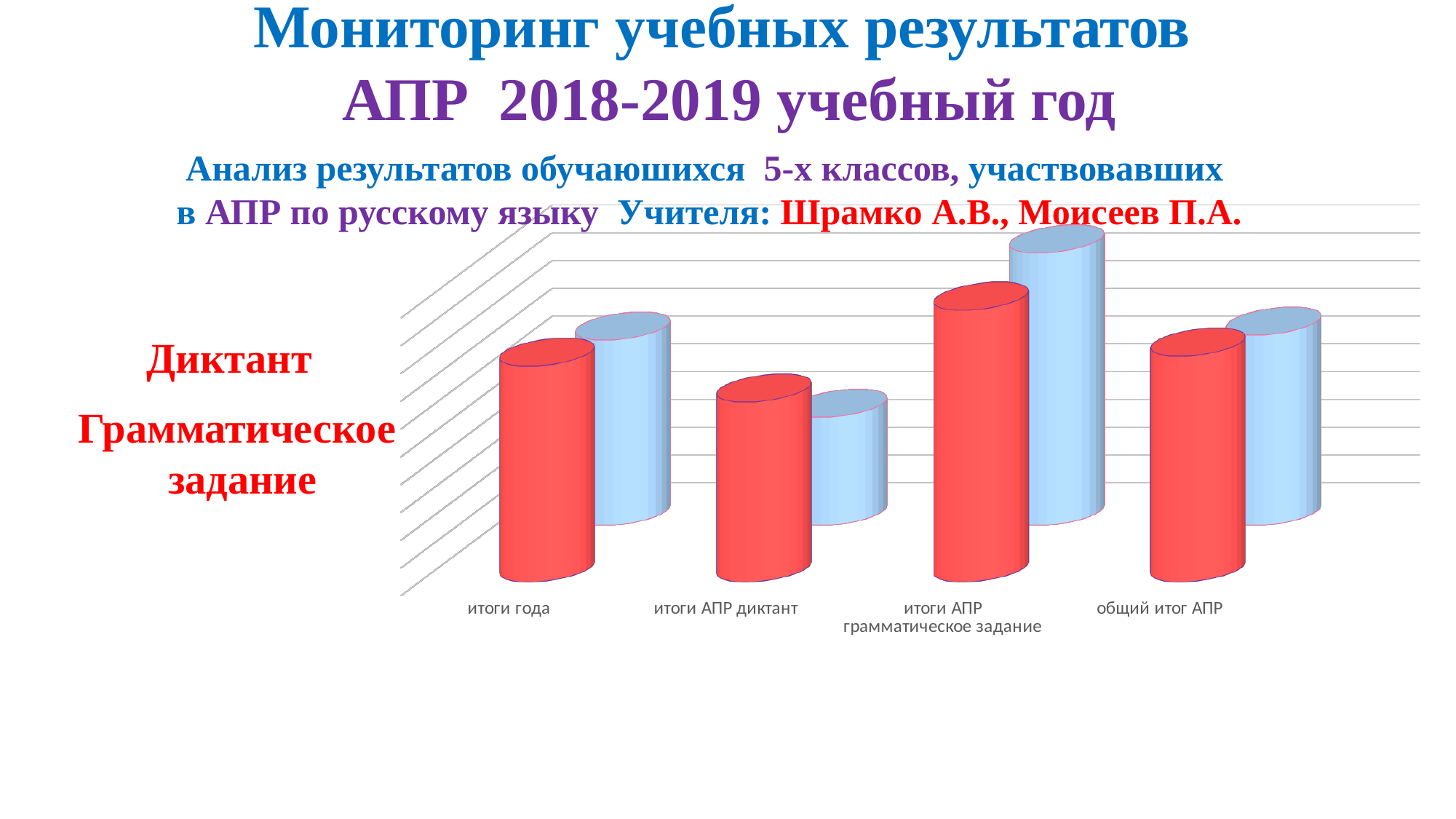
How many categories are shown along the x axis of the chart? 4 What kind of chart is shown on the slide? bar chart Which red bar is taller: итоги АПР грамматическое задание or общий итог АПР? итоги АПР грамматическое задание What is the label of the last category on the x axis? общий итог АПР For the red bars, which category has the highest value? итоги АПР грамматическое задание How many bars are plotted for each category in the chart? 2 For the light blue bars, which category has the lowest value? итоги АПР диктант For the red bars, which category has the lowest value? итоги АПР диктант For the light blue bars, which category has the highest value? итоги АПР грамматическое задание Which red bar is taller: итоги года or итоги АПР диктант? итоги года What two colours are used for the bars in the chart? red and light blue Which light blue bar is taller: итоги АПР грамматическое задание or общий итог АПР? итоги АПР грамматическое задание